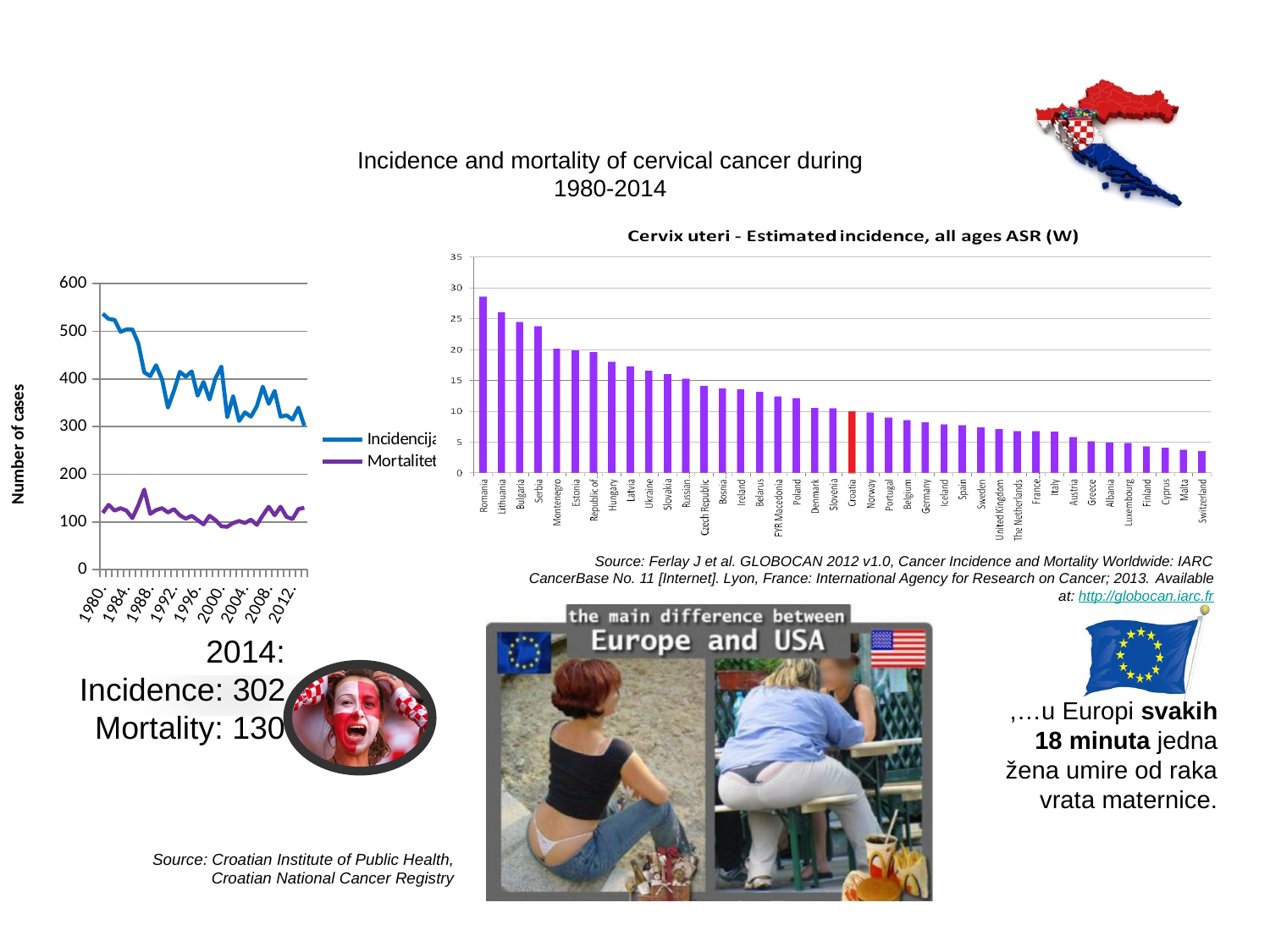
In the 'Cervix uteri - Estimated incidence' bar chart, which country's bar is highlighted in red? Croatia In the 'Cervix uteri - Estimated incidence' bar chart, is the value for Romania greater or less than 25? greater What type of chart is the 'Cervix uteri - Estimated incidence, all ages ASR (W)' chart? bar chart In the left line chart, is the Mortalitet value for 1980 greater or less than 200? less In the 'Cervix uteri - Estimated incidence' bar chart, which country has the lowest value? Switzerland In the 'Cervix uteri - Estimated incidence' bar chart, which country has the highest value? Romania What type of chart is the left chart showing incidence and mortality during 1980-2014? line chart In the 'Cervix uteri - Estimated incidence' bar chart, which has the larger value, Hungary or Croatia? Hungary In the left line chart, is the Incidencija value for 1980 greater or less than 500? greater In the left line chart, does the Incidencija series generally rise or fall from 1980 to 2012? fall How many series does the legend of the left line chart list? 2